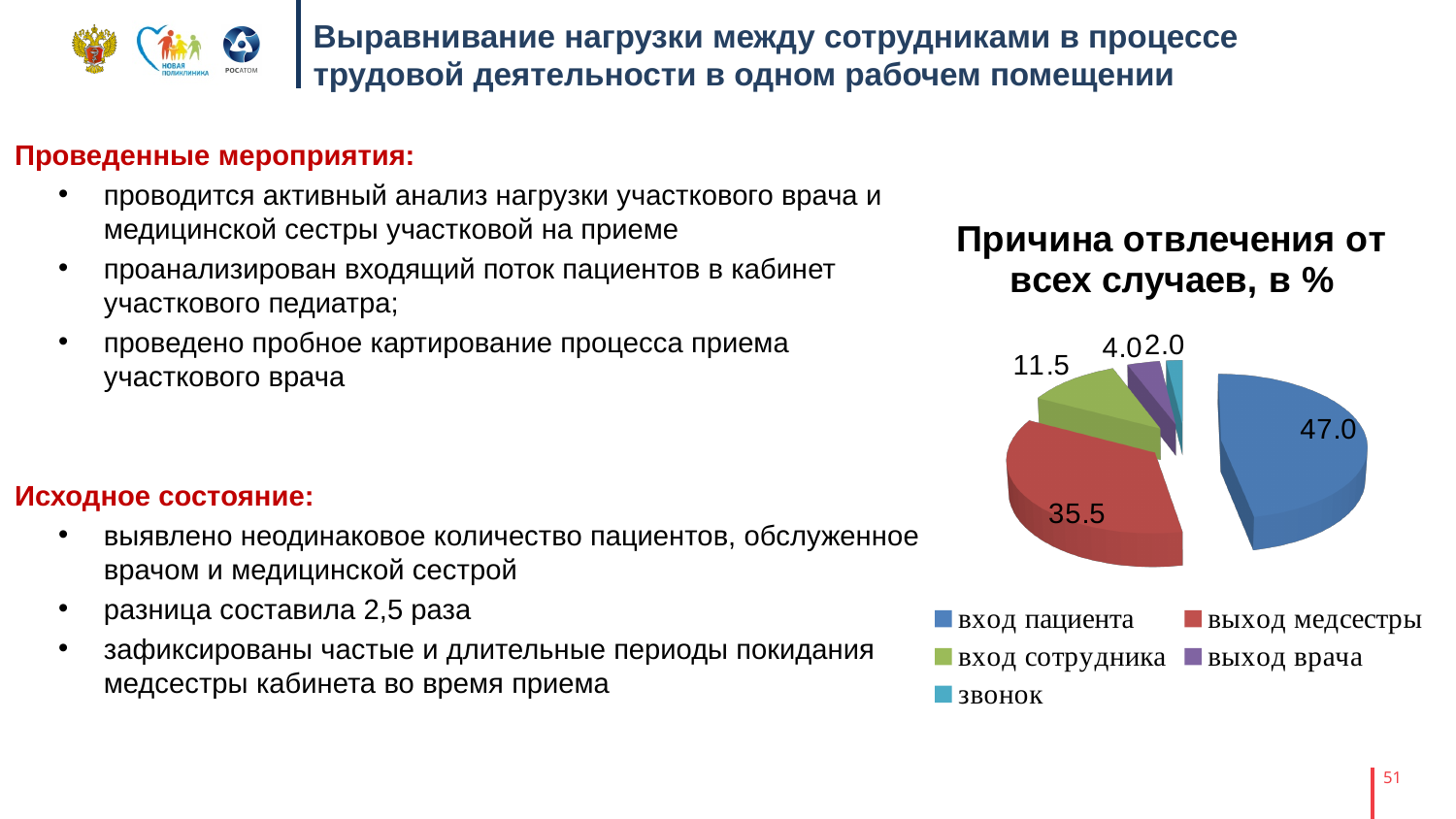
Which category has the largest slice of the pie? вход пациента What is the value for "вход сотрудника"? 11.5 What type of chart is shown on the slide? pie chart How many categories does the pie chart have? 5 Which category has the smallest slice of the pie? звонок What is the title of the chart? Причина отвлечения от всех случаев, в % What is the difference between the values for "выход врача" and "звонок"? 2.0 What is the value for "вход пациента"? 47.0 What is the difference between the values for "вход пациента" and "выход медсестры"? 11.5 Which colour represents "выход медсестры" in the pie chart? red Which is larger, the value for "вход сотрудника" or the value for "выход врача"? вход сотрудника What is the value for "выход медсестры"? 35.5